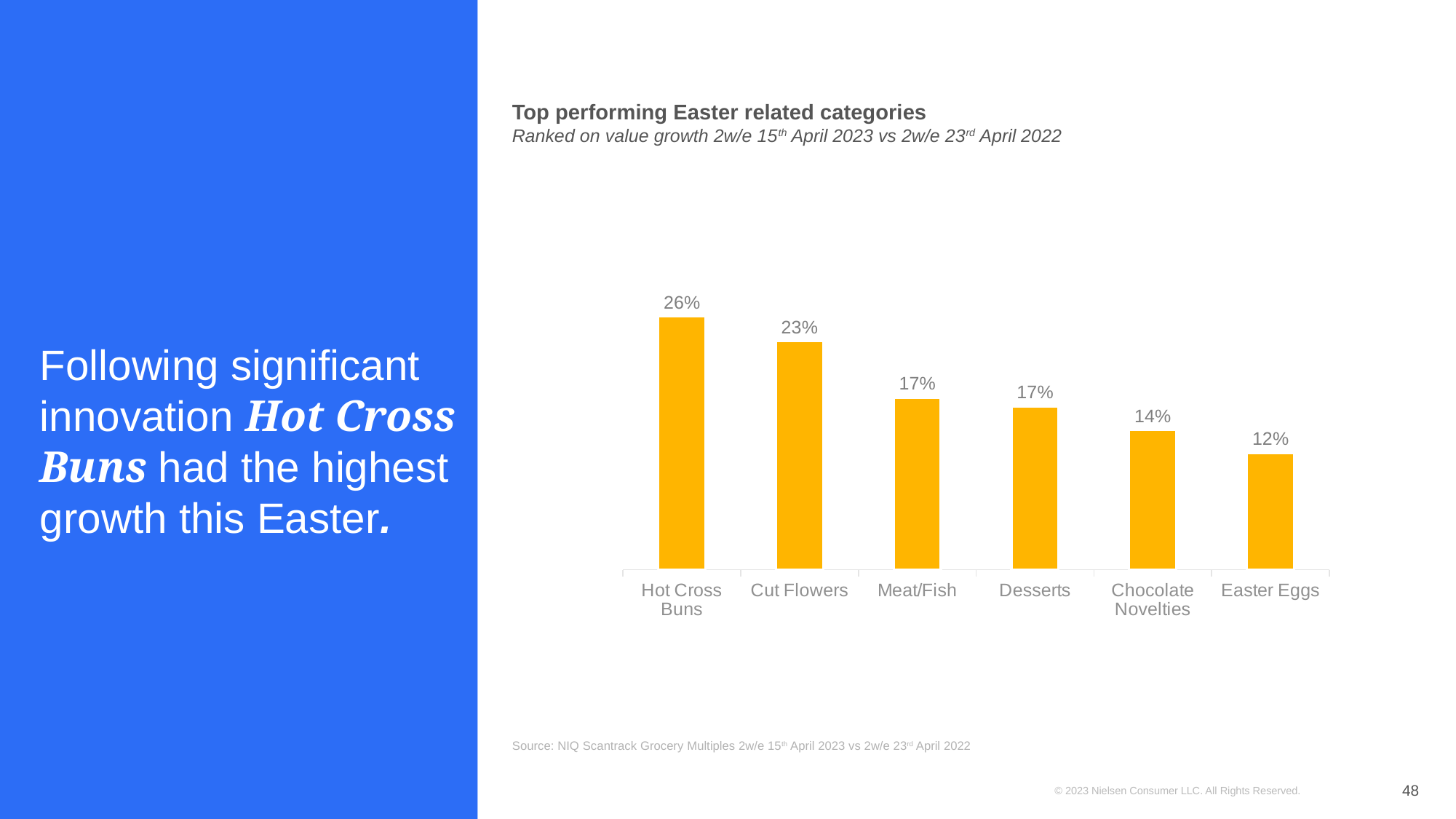
What is the value growth for Cut Flowers? 23% What is the value growth for Hot Cross Buns? 26% What is the difference in value growth between Cut Flowers and Meat/Fish? 6% Which has higher value growth, Desserts or Chocolate Novelties? Desserts Which category has the lowest value growth? Easter Eggs What is the difference in value growth between Hot Cross Buns and Easter Eggs? 14% How many categories are shown in the chart? 6 Do the values rise or fall from left to right across the categories? Fall What type of chart is shown on the slide? Bar chart What is the value growth for Easter Eggs? 12% Which category has the highest value growth? Hot Cross Buns What is the value growth for Chocolate Novelties? 14%